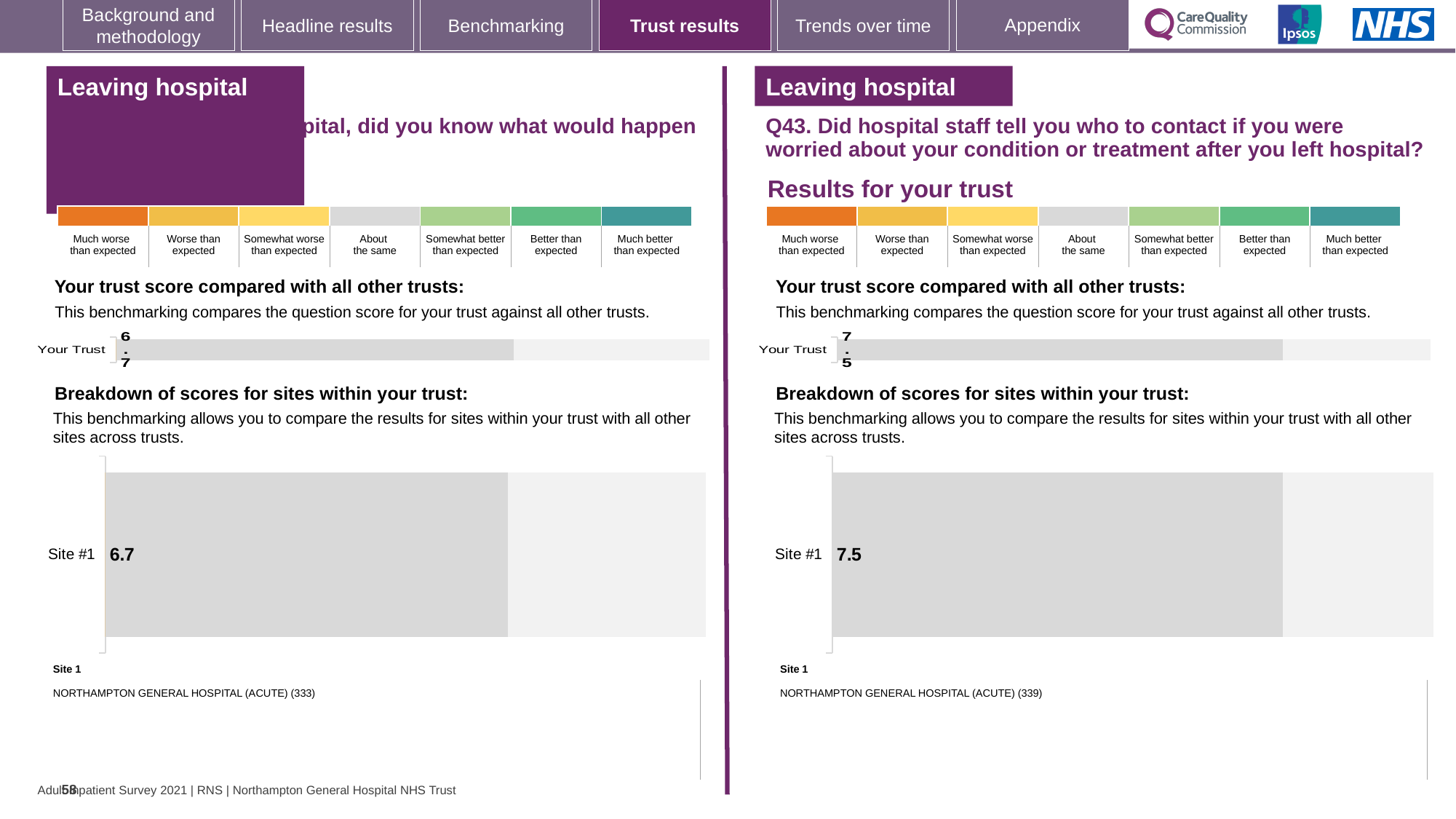
On the right panel (Q43), is the Site #1 score greater or less than the Your Trust score, or are they equal? Equal Which is larger: the Site #1 score on the left panel or the Site #1 score on the right panel (Q43)? Right panel (Q43), 7.5 On the right panel (Q43), which site name is listed as Site 1 below the chart? NORTHAMPTON GENERAL HOSPITAL (ACUTE) (339) On the left panel, what is the score shown for Site #1 in the breakdown of scores for sites within your trust? 6.7 On the left panel, which site name is listed as Site 1 below the chart? NORTHAMPTON GENERAL HOSPITAL (ACUTE) (333) On the left panel, what is the value shown for Your Trust in the trust score comparison chart? 6.7 On the right panel (Q43), what is the score shown for Site #1 in the breakdown of scores for sites within your trust? 7.5 On the right panel (Q43), what is the value shown for Your Trust in the trust score comparison chart? 7.5 What type of chart is used to show the Site #1 score on the right panel (Q43)? Bar chart How many sites are shown in the breakdown of scores chart on the right panel (Q43)? 1 How many sites are shown in the breakdown of scores chart on the left panel? 1 What is the difference between the Site #1 score on the right panel (Q43) and the Site #1 score on the left panel? 0.8